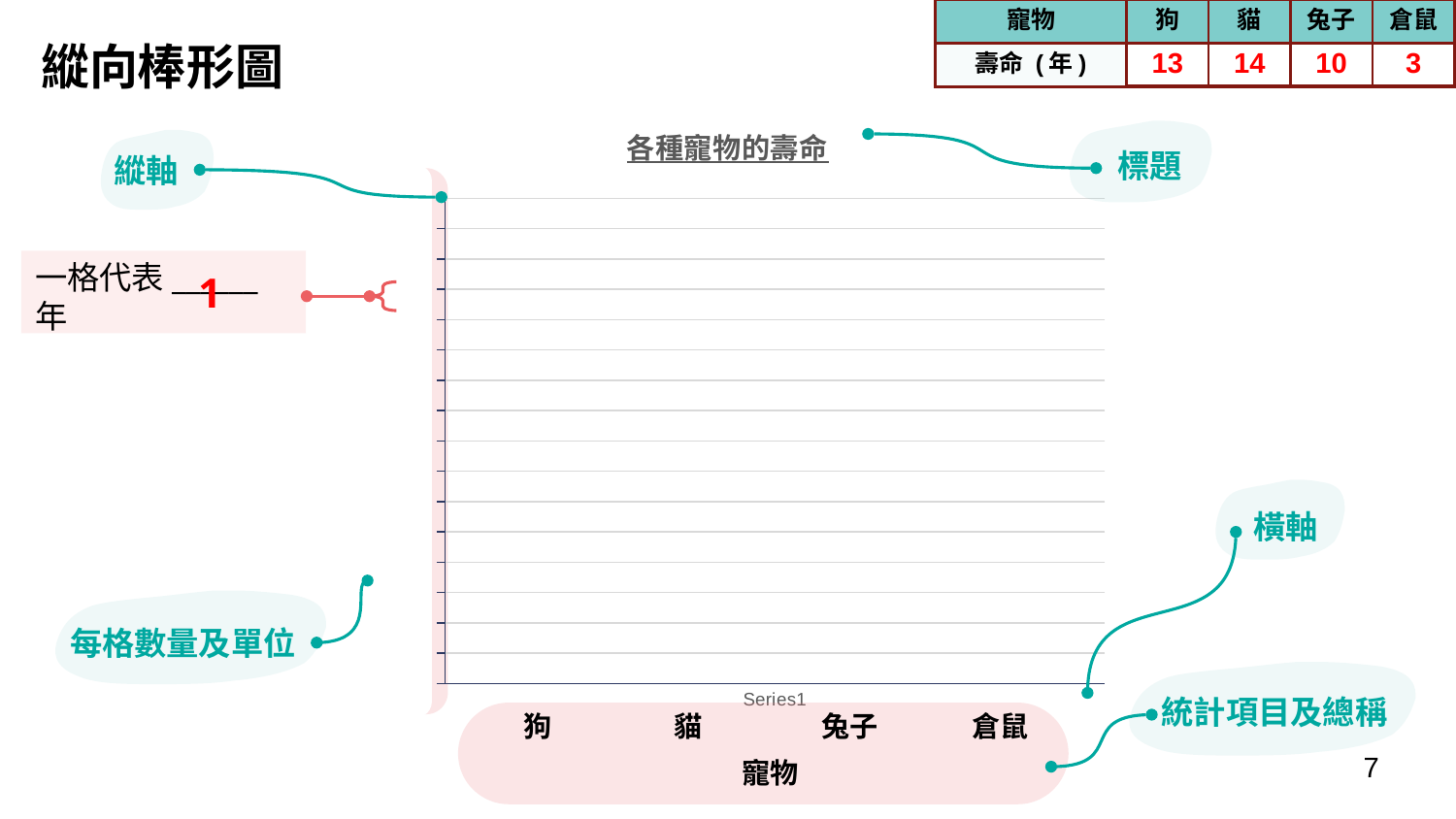
According to the data table on the slide, what is the lifespan (壽命) of 倉鼠? 3 According to the data table on the slide, what is the difference in lifespan between 貓 and 兔子? 4 What kind of chart is shown on the slide? bar chart According to the data table on the slide, which pet has the shortest lifespan? 倉鼠 How many categories are shown on the x axis of the chart? 4 According to the data table on the slide, what is the lifespan (壽命) of 狗? 13 According to the data table on the slide, which pet has the longest lifespan? 貓 What is the title of the chart on the slide? 各種寵物的壽命 What is the label of the x axis of the chart? 寵物 According to the data table on the slide, which has a longer lifespan, 狗 or 兔子? 狗